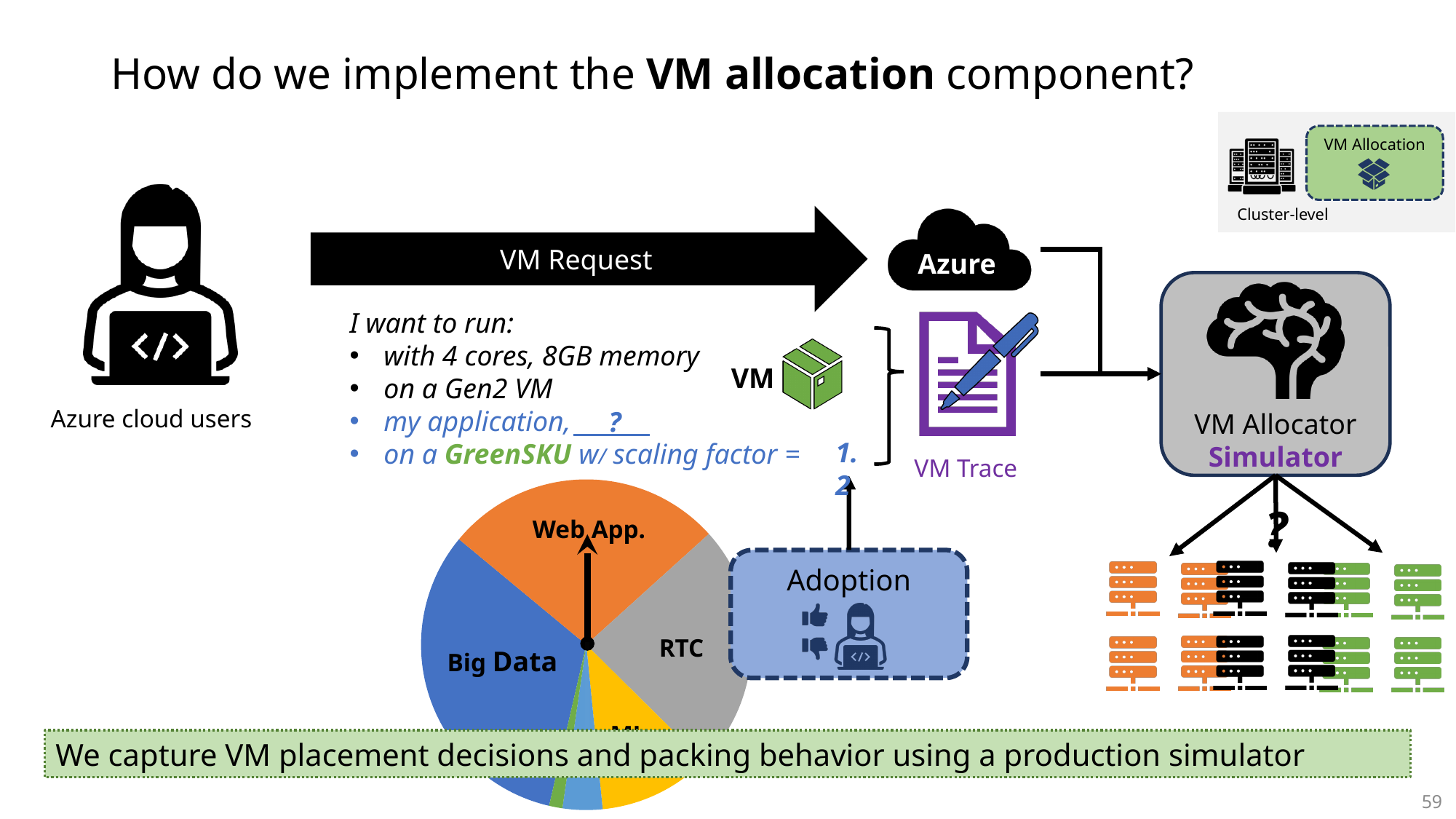
In the pie chart, what colour is the Web App. slice? orange In the pie chart, which slice is larger, Big Data or RTC? Big Data In the pie chart, which slice is larger, Web App. or RTC? Web App. In the pie chart, what colour is the Big Data slice? blue What kind of chart is shown at the bottom of the slide, below the VM request text? pie chart